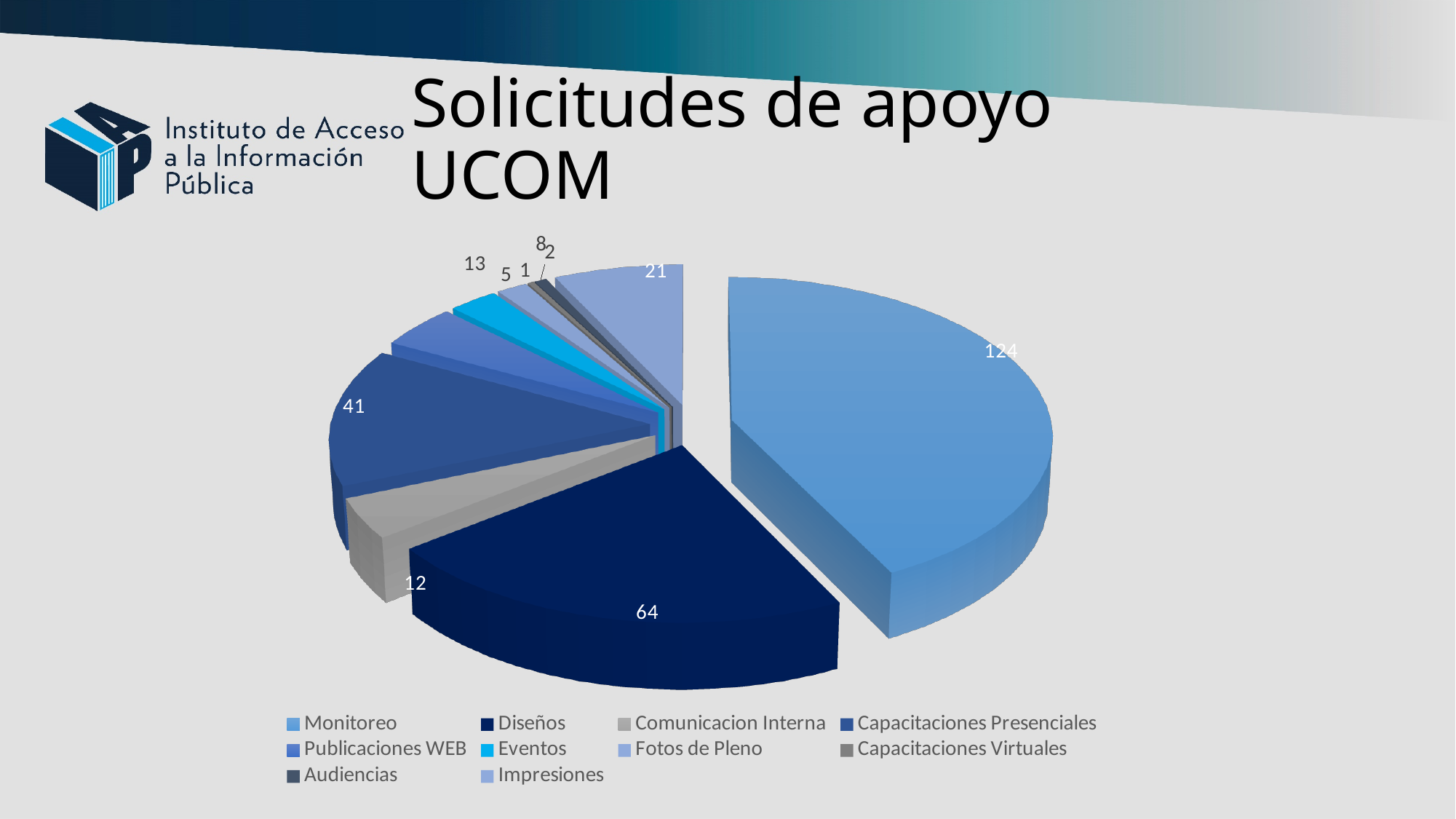
What is the total of all the values in the pie chart? 291 What is the value for Monitoreo? 124 How many categories does the legend list? 10 What is the title of the chart? Solicitudes de apoyo UCOM What is the value for Diseños? 64 What is the value for Capacitaciones Presenciales? 41 Which category has the largest slice? Monitoreo What is the value for Impresiones? 21 Which category has the smallest slice? Capacitaciones Virtuales What kind of chart is shown on the slide? pie chart What is the difference between the values for Monitoreo and Diseños? 60 Which is larger, Comunicacion Interna or Publicaciones WEB? Publicaciones WEB